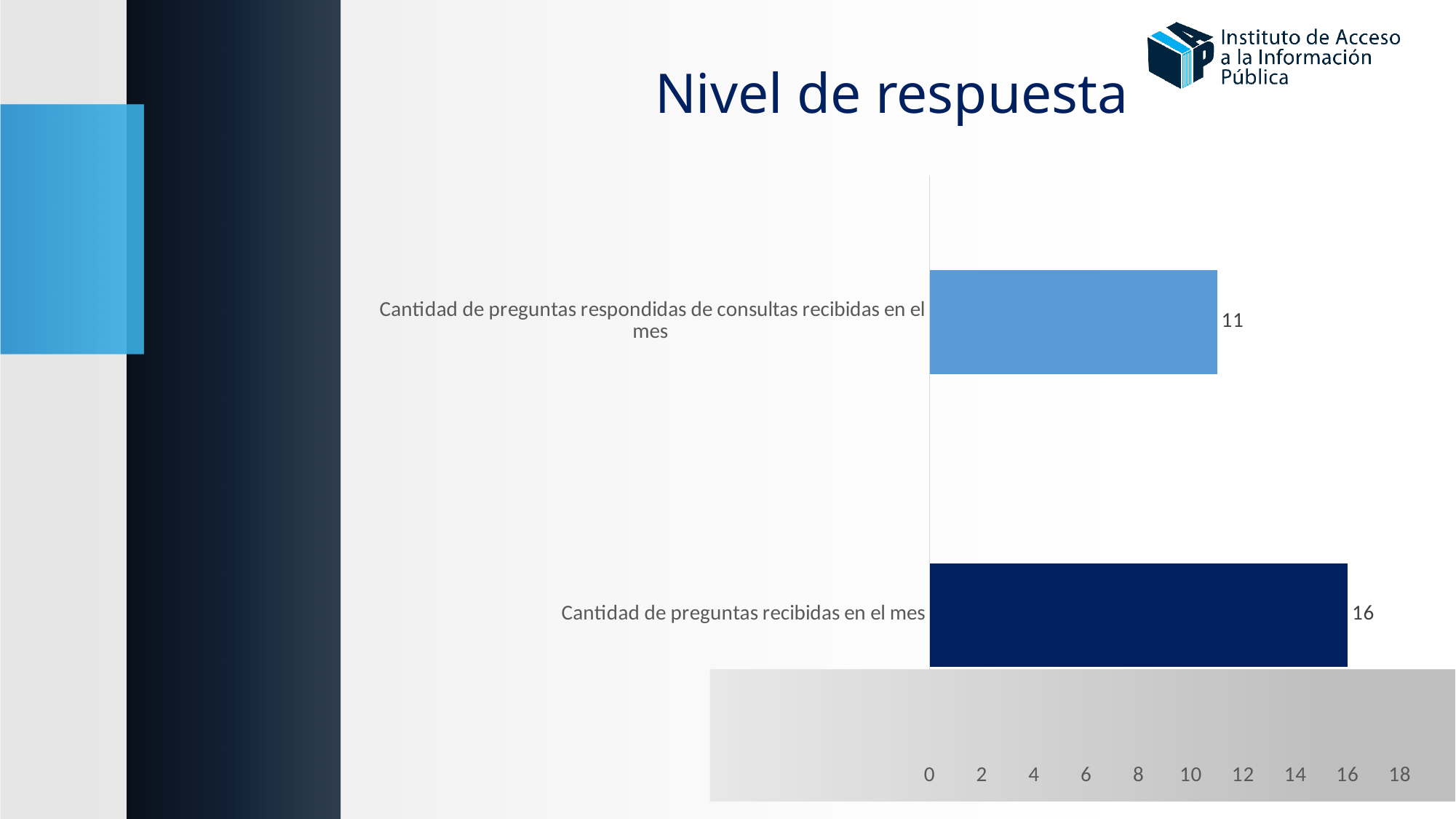
What is the value for "Cantidad de preguntas recibidas en el mes"? 16 Which is larger: the value for questions received in the month or the value for questions answered? Cantidad de preguntas recibidas en el mes Is the value for "Cantidad de preguntas recibidas en el mes" greater or less than 14? greater What kind of chart is shown on the slide? bar chart What is the maximum value shown on the horizontal axis? 18 Is the value for "Cantidad de preguntas respondidas de consultas recibidas en el mes" greater or less than 12? less What is the difference between the number of questions received and the number of questions answered in the month? 5 What is the title of the slide? Nivel de respuesta How many categories are shown in the chart? 2 Which category has the highest value? Cantidad de preguntas recibidas en el mes Which category has the lowest value? Cantidad de preguntas respondidas de consultas recibidas en el mes What is the value for "Cantidad de preguntas respondidas de consultas recibidas en el mes"? 11